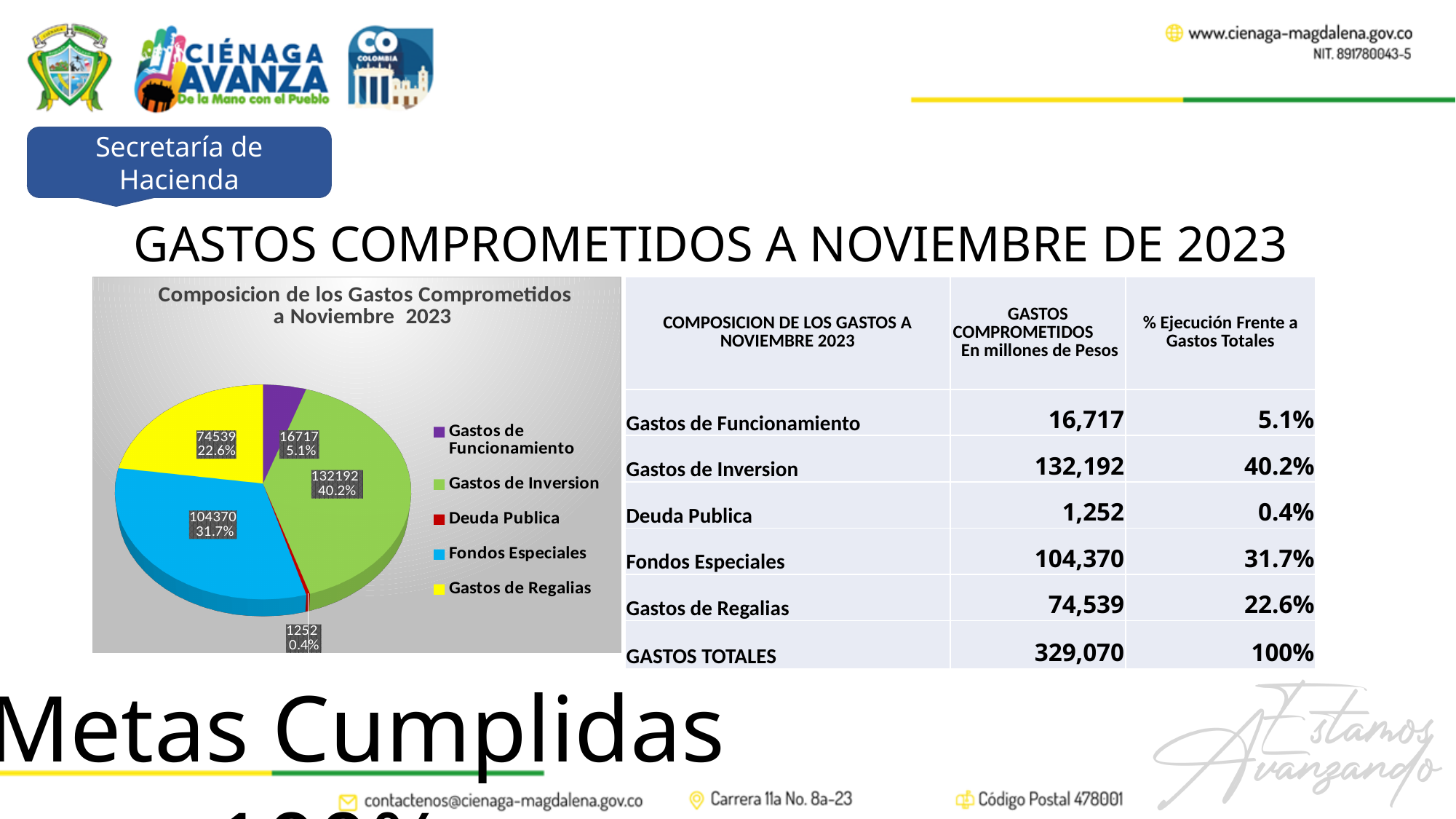
What share of the pie does Gastos de Regalias represent? 22.6% Which category has the largest slice in the pie chart? Gastos de Inversion What is the difference between the values for Gastos de Inversion and Fondos Especiales in the pie chart? 27822 How many slices does the pie chart have? 5 What value is shown for Gastos de Inversion in the pie chart? 132192 What is the title of the pie chart? Composicion de los Gastos Comprometidos a Noviembre 2023 What kind of chart is shown on the slide? pie chart What value is shown for Deuda Publica in the pie chart? 1252 What share of the pie does Gastos de Funcionamiento represent? 5.1% Which category has the smallest slice in the pie chart? Deuda Publica Which is larger in the pie chart, Fondos Especiales or Gastos de Regalias? Fondos Especiales What value is shown for Fondos Especiales in the pie chart? 104370